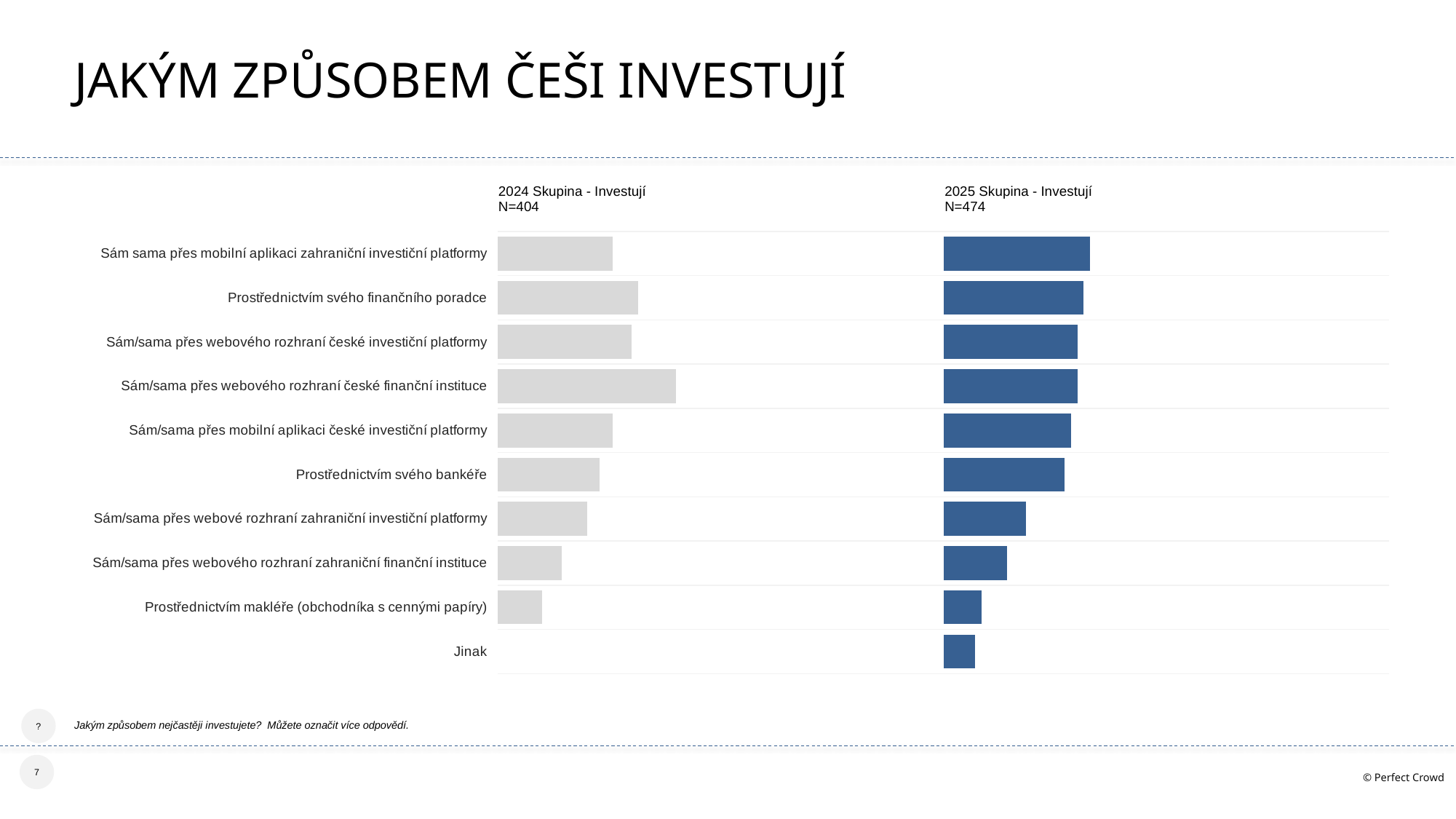
In the 2024 Skupina - Investují chart, which is larger: Sám/sama přes webového rozhraní české finanční instituce or Prostřednictvím svého finančního poradce? Sám/sama přes webového rozhraní české finanční instituce In the 2025 Skupina - Investují chart, which is larger: Prostřednictvím svého bankéře or Sám/sama přes webové rozhraní zahraniční investiční platformy? Prostřednictvím svého bankéře What is the sample size (N) shown for the 2024 Skupina - Investují chart? N=404 How many categories are listed on the slide? 10 In the 2025 Skupina - Investují chart, which category has the shortest bar? Jinak In the 2024 Skupina - Investují chart, which category has the longest bar? Sám/sama přes webového rozhraní české finanční instituce What is the sample size (N) shown for the 2025 Skupina - Investují chart? N=474 In the 2025 Skupina - Investují chart, do the bars get longer or shorter going down the list of categories? shorter What kind of chart is used on this slide? bar chart In the 2024 Skupina - Investují chart, which is larger: Sám/sama přes webového rozhraní zahraniční finanční instituce or Prostřednictvím makléře (obchodníka s cennými papíry)? Sám/sama přes webového rozhraní zahraniční finanční instituce